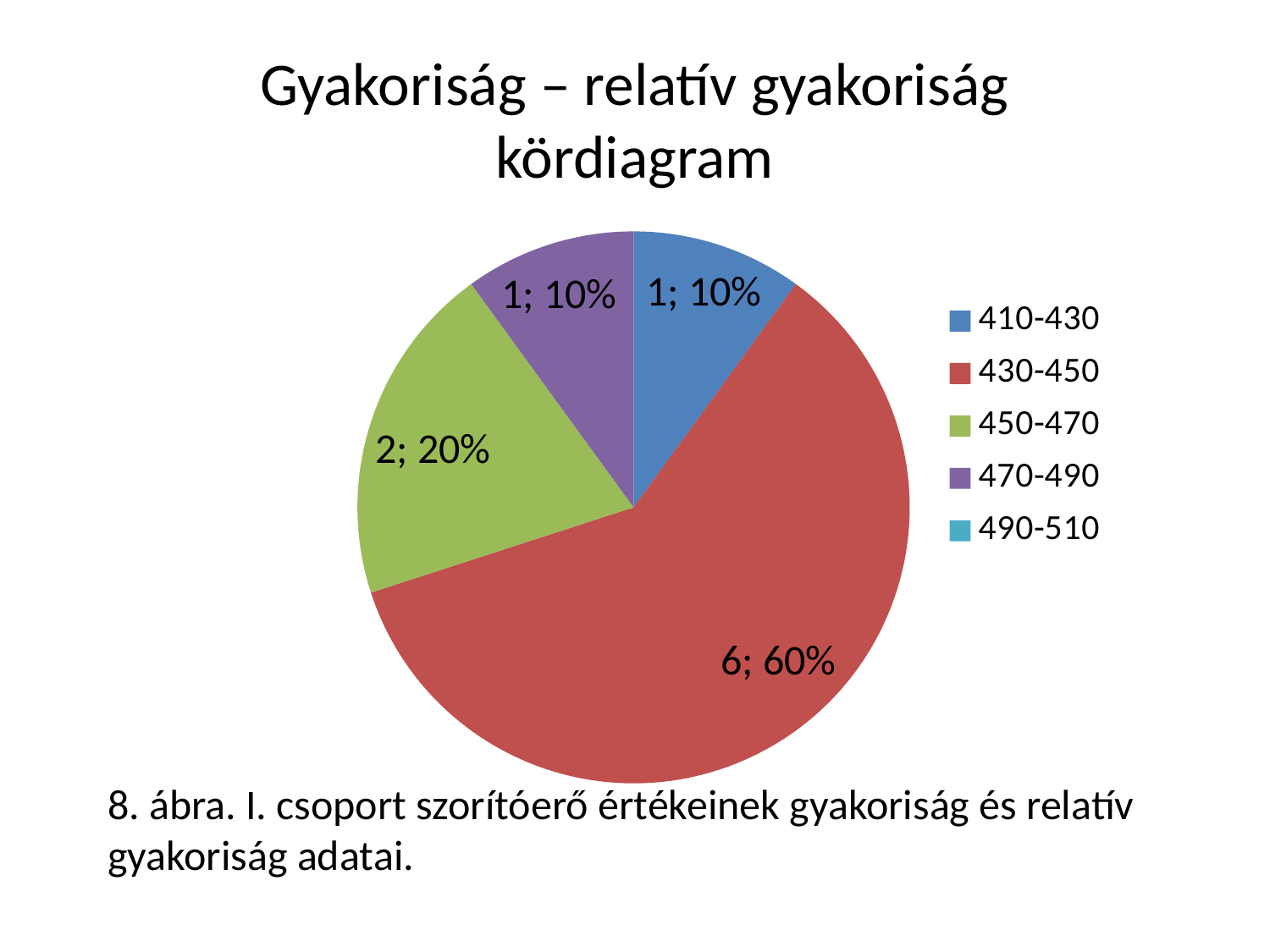
How many categories does the legend list? 5 What colour is the slice for the 430-450 category? red What percentage share does the 450-470 slice have? 20% What is the frequency shown for the 470-490 category? 1 What is the title of the chart? Gyakoriság – relatív gyakoriság kördiagram What percentage share does the 430-450 slice have? 60% Which is larger, the slice for 450-470 or the slice for 410-430? 450-470 What is the frequency shown for the 450-470 category? 2 What is the frequency (count) shown for the 430-450 category? 6 Which category has the largest slice of the pie? 430-450 What is the difference in frequency between the 430-450 and 450-470 categories? 4 What kind of chart is shown on the slide? pie chart